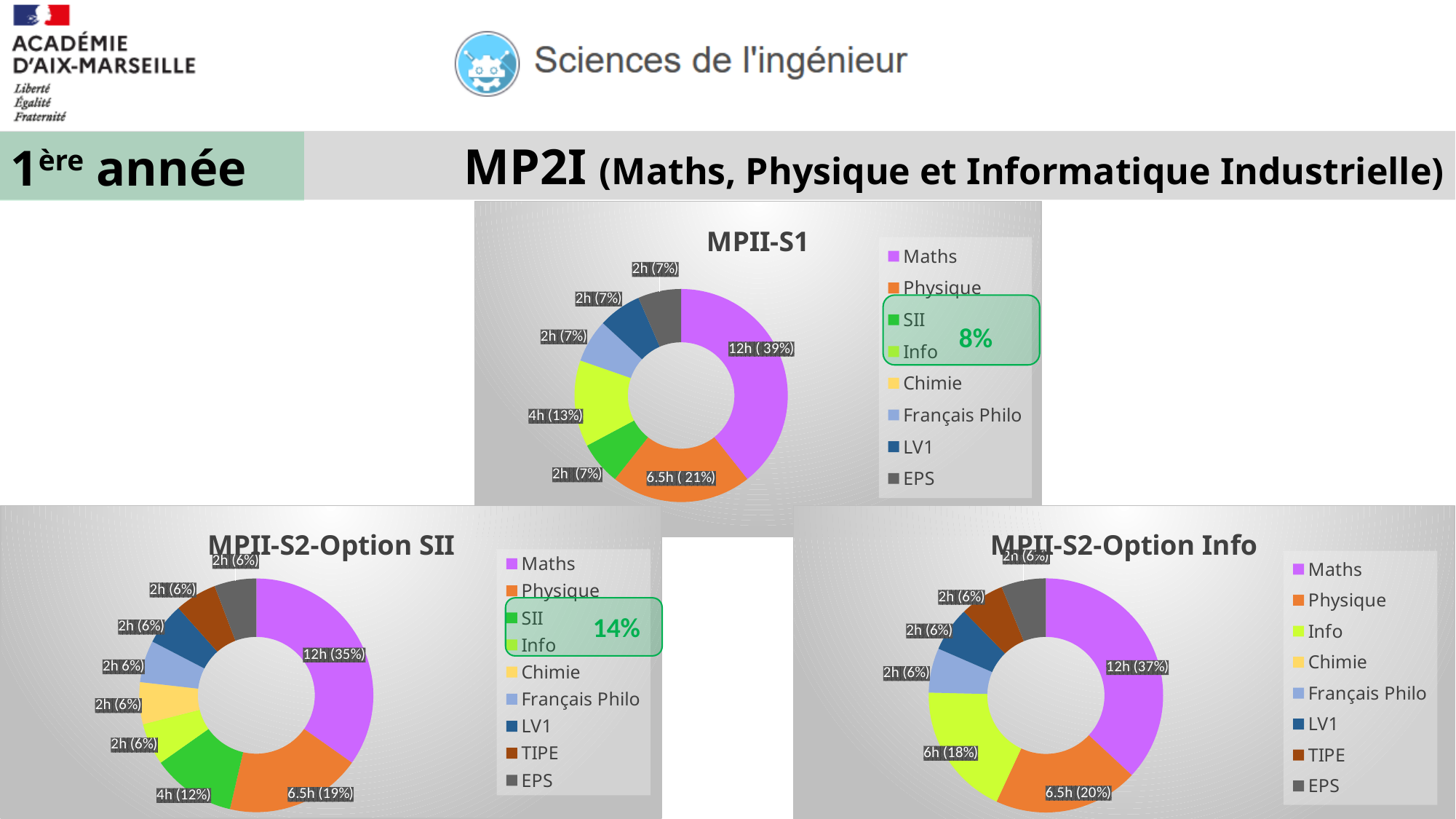
In the MPII-S2-Option Info chart, which is larger, the share for Maths or the share for Physique? Maths In the MPII-S1 chart, what is the value shown for Physique? 6.5h (21%) In the MPII-S2-Option Info chart, what is the value shown for Info? 6h (18%) In the MPII-S1 chart, what is the value shown for Maths? 12h (39%) In the MPII-S2-Option SII chart, what is the value shown for Maths? 12h (35%) In the MPII-S1 chart, what is the value shown for Info? 4h (13%) What percentage is written in the green box next to SII and Info in the legend of the MPII-S2-Option SII chart? 14% In the MPII-S1 chart, which subject has the largest share? Maths What kind of chart is the MPII-S1 chart? Doughnut chart How many entries does the legend of the MPII-S2-Option SII chart list? 9 In the MPII-S2-Option Info chart, what is the value shown for Physique? 6.5h (20%) In the MPII-S2-Option SII chart, what is the value shown for SII? 4h (12%)